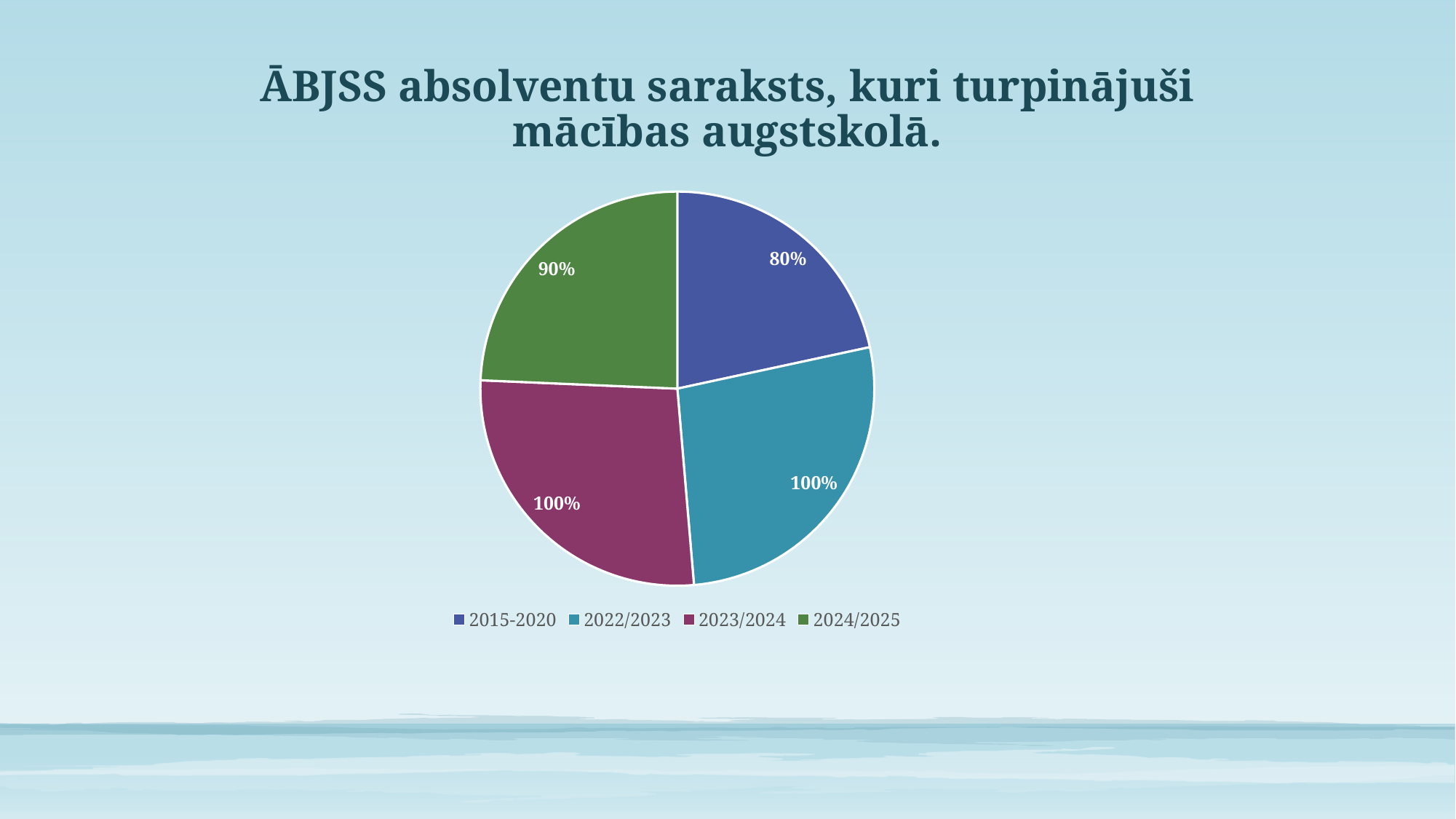
What is the value shown for the 2023/2024 slice? 100% Which is larger, the value for 2015-2020 or the value for 2024/2025? 2024/2025 Which category has the lowest value in the pie chart? 2015-2020 How many slices does the pie chart have? 4 What is the difference between the value for 2024/2025 and the value for 2015-2020? 10% What is the title of the chart? ĀBJSS absolventu saraksts, kuri turpinājuši mācības augstskolā. How many entries does the legend list? 4 What kind of chart is shown on the slide? pie chart Which legend entry is shown in green? 2024/2025 What is the value shown for the 2015-2020 slice? 80% What is the value shown for the 2022/2023 slice? 100% What is the value shown for the 2024/2025 slice? 90%